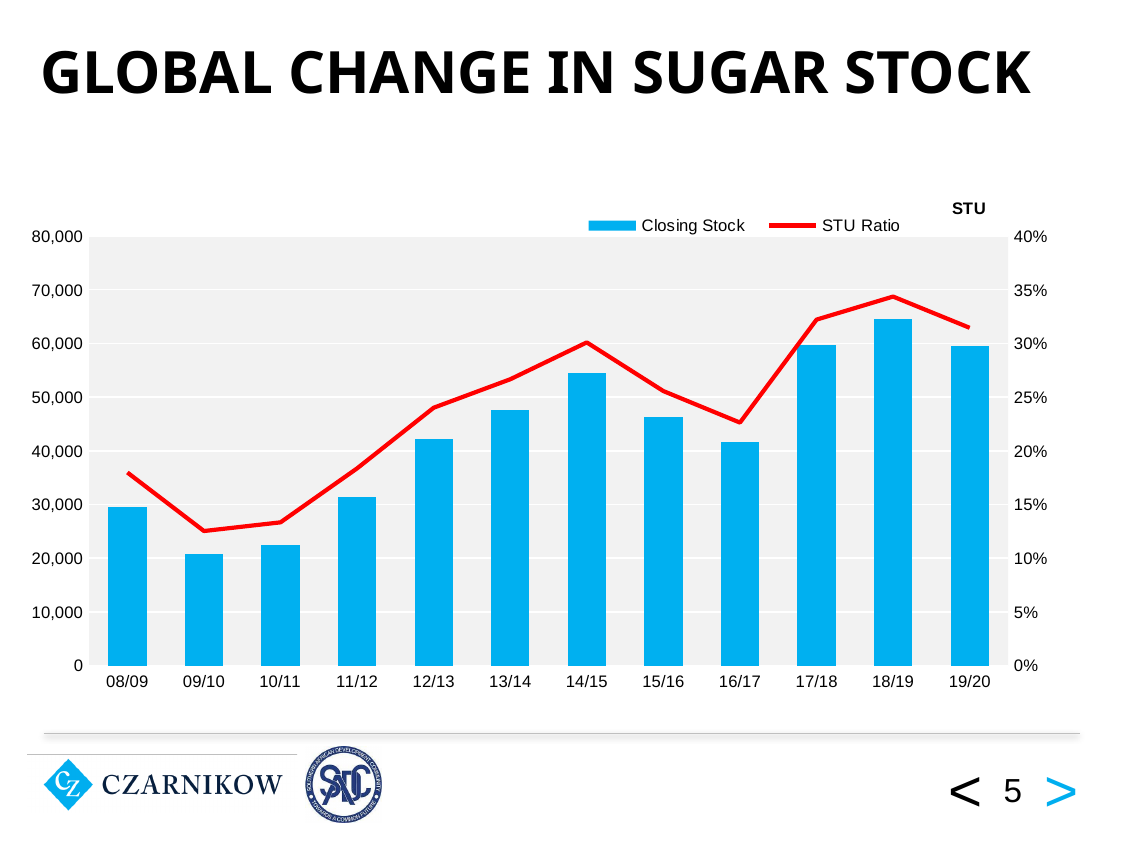
Is the Closing Stock value for 12/13 greater or less than 40,000? greater Is the Closing Stock value for 09/10 greater or less than 30,000? less How many series does the legend list? 2 Which season has the highest Closing Stock bar? 18/19 What colour is the STU Ratio line? Red What kind of chart is shown on the slide? Combined bar and line chart Does the Closing Stock rise or fall from 16/17 to 18/19? rise In which season does the STU Ratio line reach its highest point? 18/19 Which season has the lowest Closing Stock bar? 09/10 Which has the larger Closing Stock, 13/14 or 16/17? 13/14 How many seasons are shown on the x axis? 12 Is the STU Ratio for 16/17 greater or less than 25%? less